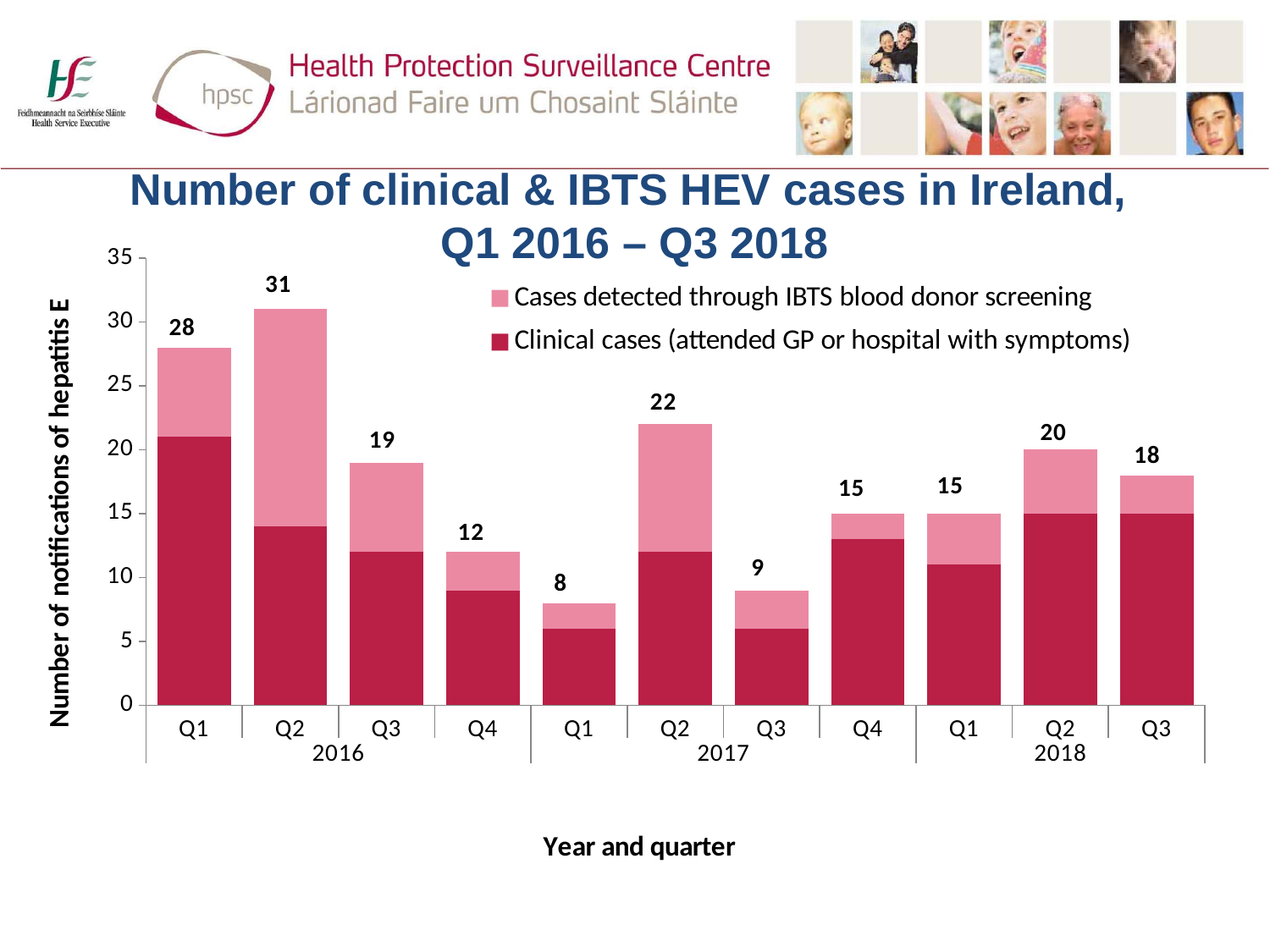
What is the total number of HEV cases in Q2 2018? 20 Is the number of clinical cases in Q1 2016 greater or less than 20? greater What is the total number of HEV cases in Q1 2017? 8 What is the difference between the total cases in Q2 2016 and Q2 2017? 9 What is the total number of HEV cases in Q2 2016? 31 Which quarter has the highest total number of HEV cases? Q2 2016 Which has more total HEV cases, Q3 2017 or Q3 2018? Q3 2018 How many series does the legend list? 2 Is the number of clinical cases in Q2 2016 greater or less than 15? less What kind of chart is shown on the slide? Stacked bar chart Which quarter has the lowest total number of HEV cases? Q1 2017 How many quarters are shown on the x axis? 11